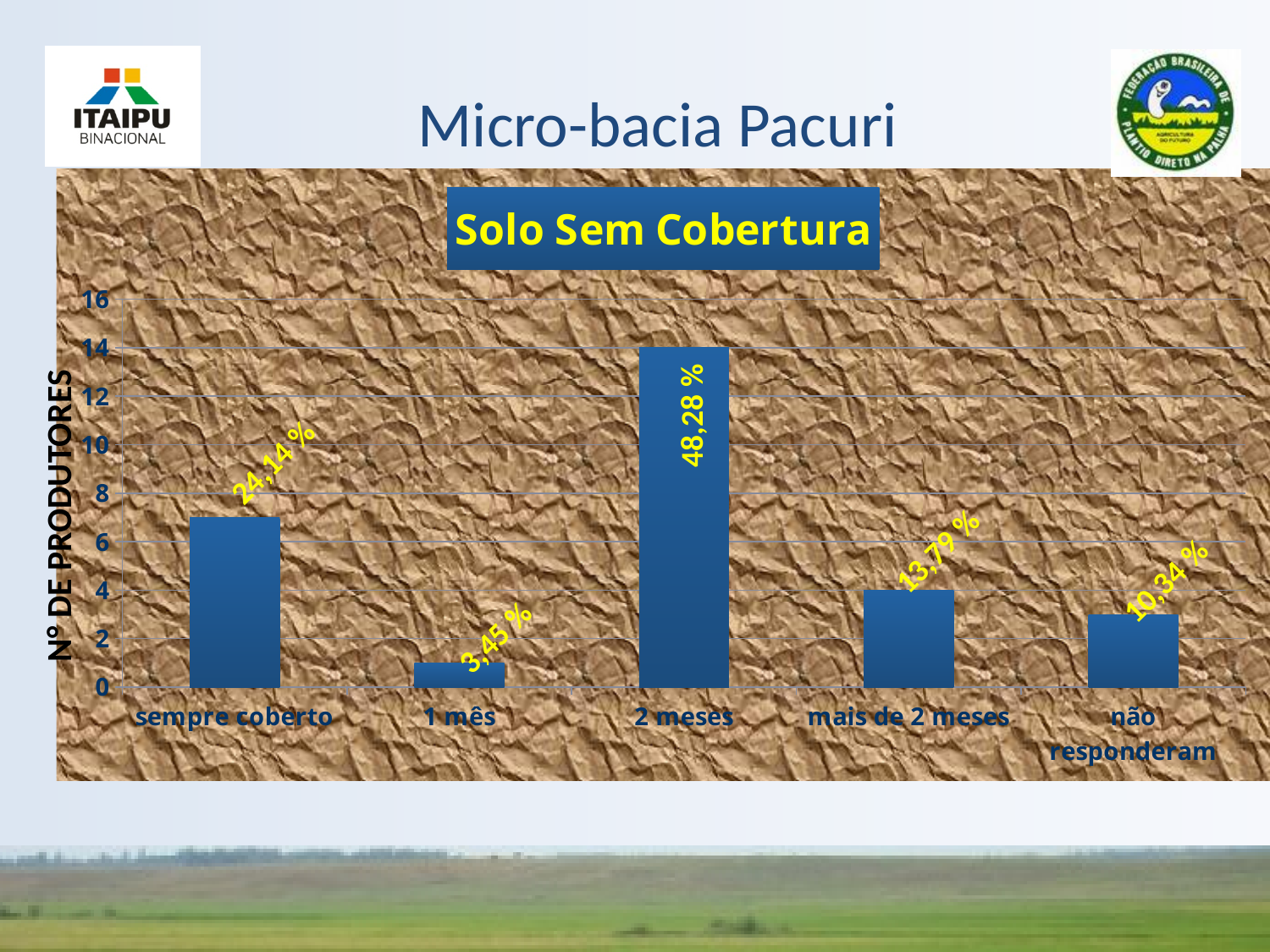
What kind of chart is shown on the slide? bar chart How many categories are shown on the x axis of the chart? 5 Is the number of producers for 'sempre coberto' greater or less than 6? greater What percentage label is shown for the 'sempre coberto' bar? 24,14 % What percentage label is shown for the '1 mês' bar? 3,45 % What is the title of the chart? Solo Sem Cobertura What percentage label is shown for the '2 meses' bar? 48,28 % Which category has the highest number of producers? 2 meses What percentage label is shown for the 'não responderam' bar? 10,34 % Which category has the lowest number of producers? 1 mês What is the difference between the percentage labels for '2 meses' and 'sempre coberto'? 24,14 % What percentage label is shown for the 'mais de 2 meses' bar? 13,79 %